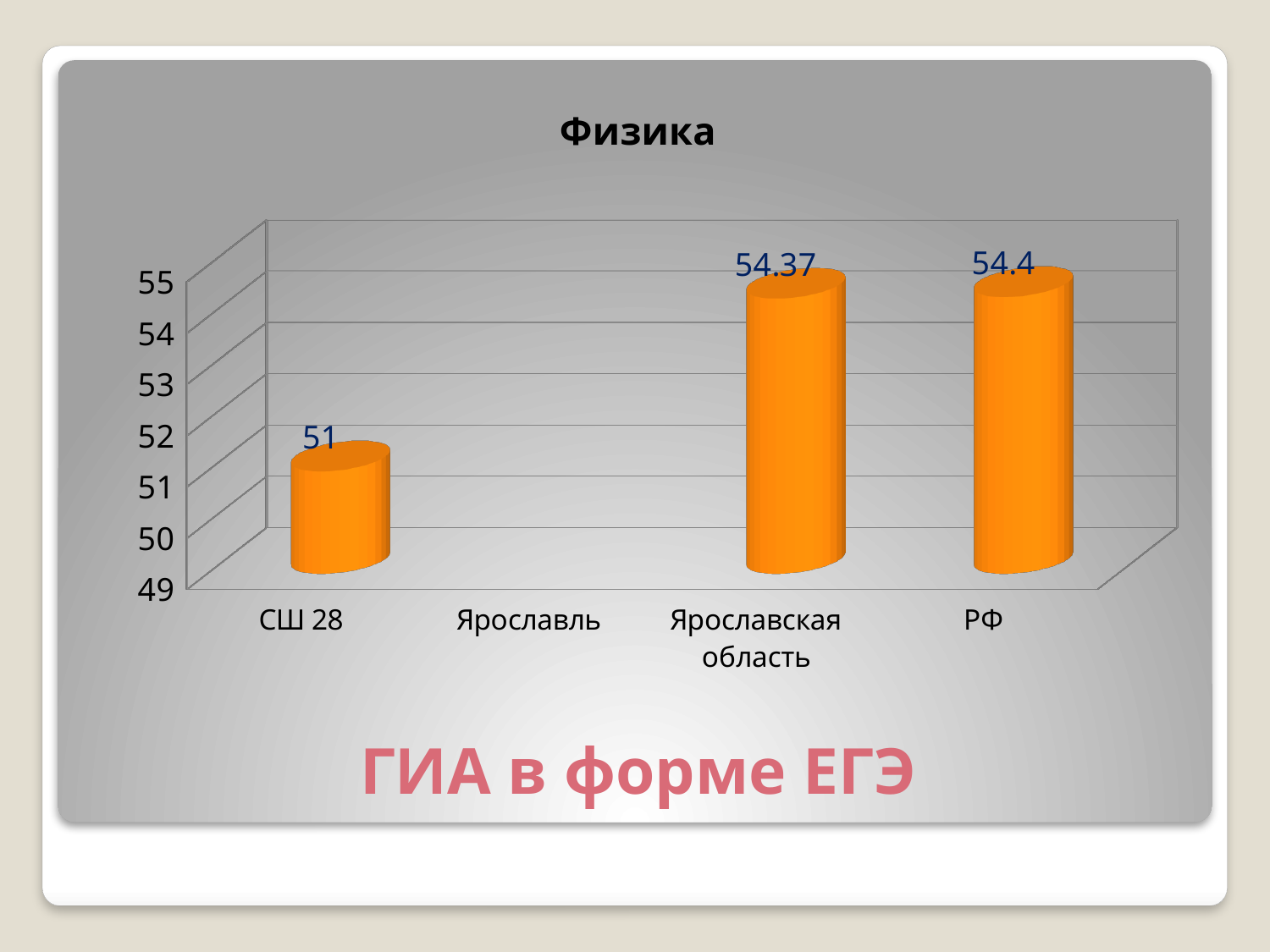
How many categories are labelled on the x axis of the chart? 4 What kind of chart is shown on the slide? bar chart What is the title of the chart? Физика What is the value for Ярославская область in the Физика chart? 54.37 What is the value for СШ 28 in the Физика chart? 51 What is the difference between the values for РФ and СШ 28? 3.4 What is the value for РФ in the Физика chart? 54.4 Is the value for РФ greater or less than 54? greater Which is larger, the value for СШ 28 or the value for Ярославская область? Ярославская область Is the value for СШ 28 greater or less than 52? less Which category has the lowest value in the Физика chart? СШ 28 What is the difference between the values for Ярославская область and СШ 28? 3.37